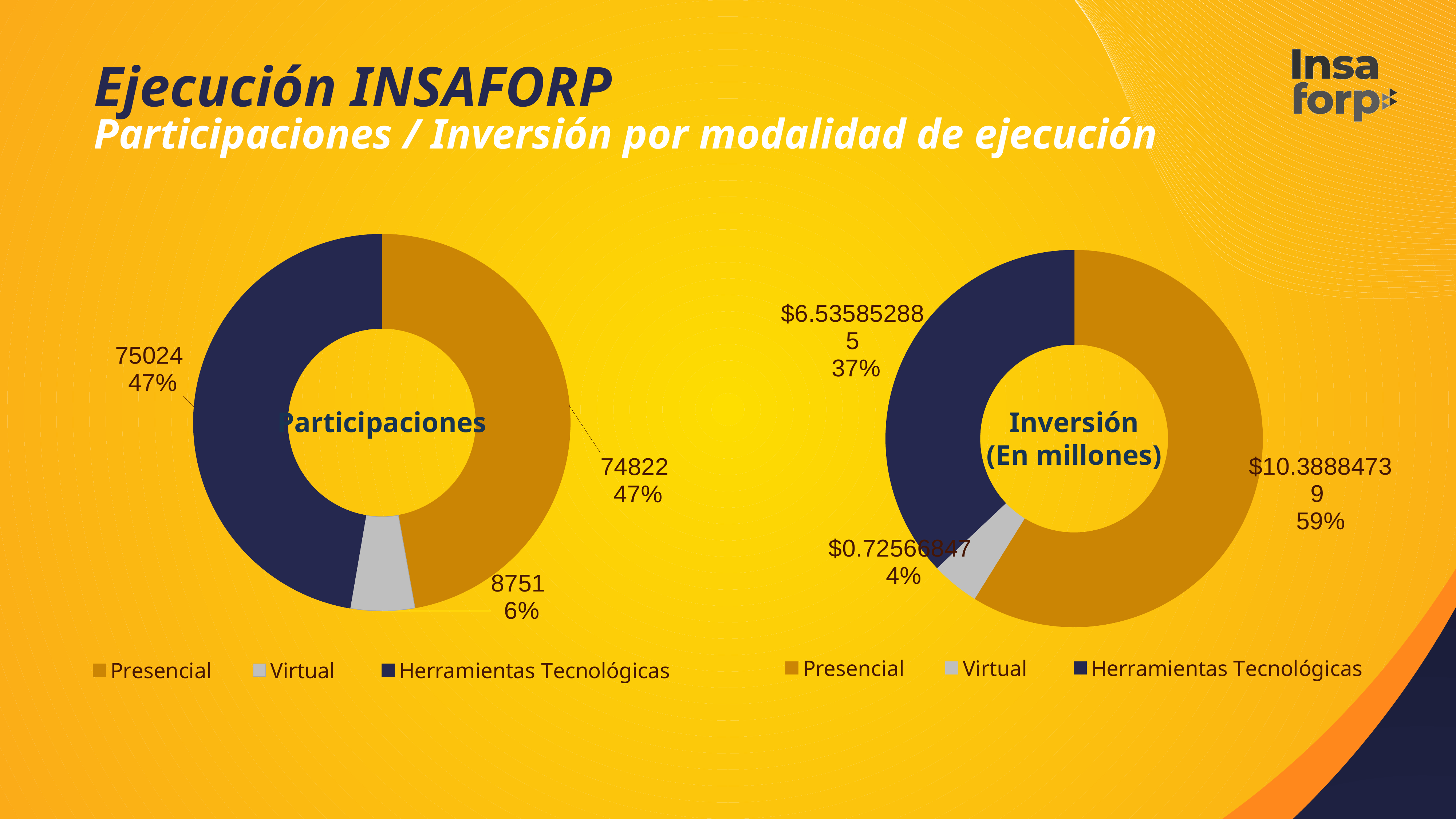
On the Participaciones chart, what is the value for Herramientas Tecnológicas? 75024 What kind of chart is the Participaciones chart? Donut (pie) chart On the Inversión (En millones) chart, what percentage share does Presencial have? 59% On the Participaciones chart, what percentage share does Virtual have? 6% On the Participaciones chart, what is the difference between the Herramientas Tecnológicas value and the Presencial value? 202 On the Inversión (En millones) chart, what percentage share does Herramientas Tecnológicas have? 37% On the Inversión (En millones) chart, what is the value for Virtual? $0.72566847 On the Inversión (En millones) chart, which category has the highest value? Presencial On the Participaciones chart, which category has the lowest value? Virtual How many categories does the legend of the Inversión (En millones) chart list? 3 On the Participaciones chart, what is the value for Presencial? 74822 On the Participaciones chart, what is the total of all three categories? 158597